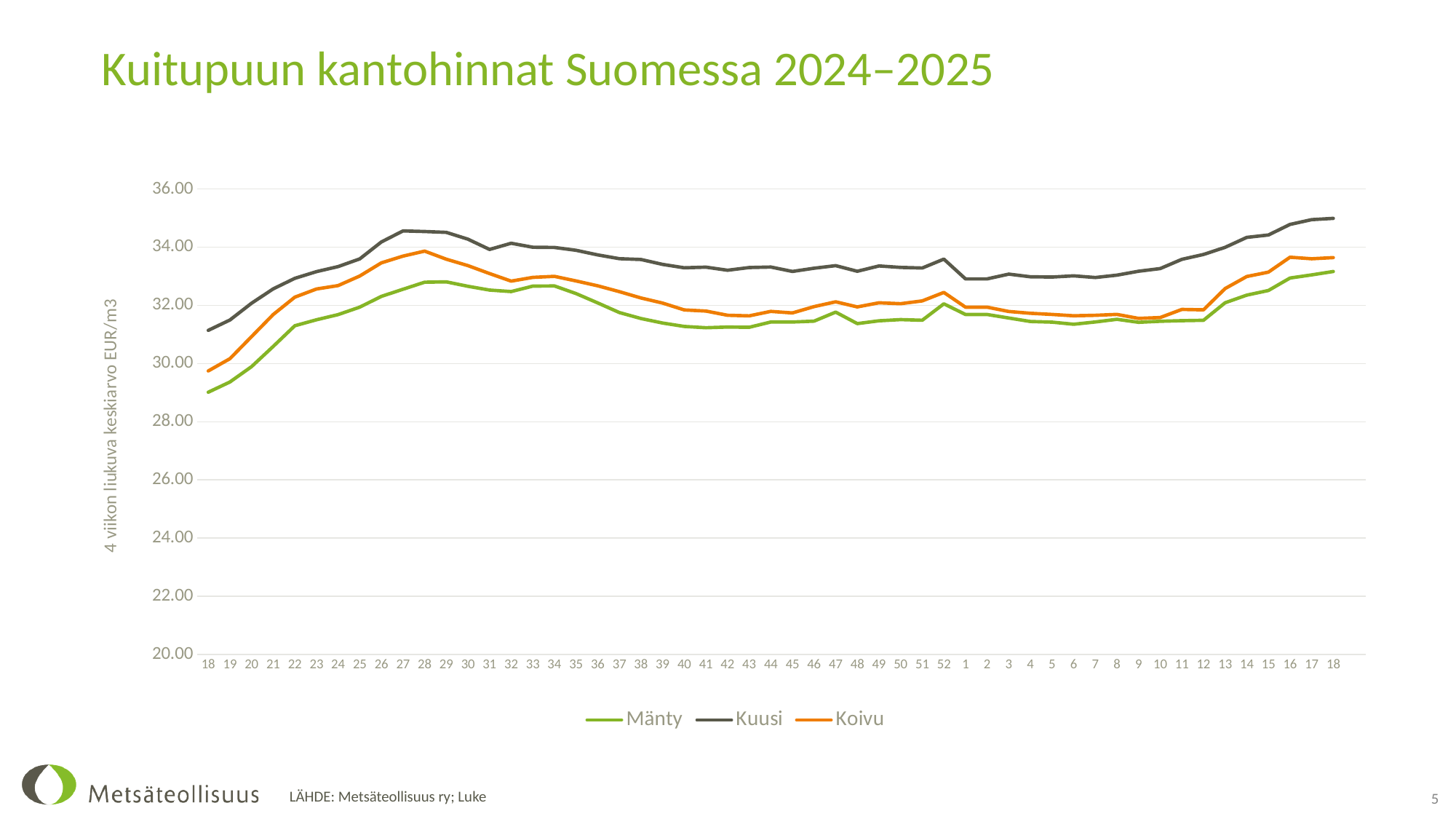
How many series does the legend list? 3 Which series is plotted with the orange line? Koivu Is the value for Koivu at week 40 greater or less than 32.00? less What kind of chart is shown on the slide? line chart Does the Mänty line rise or fall from week 18 to week 27? rise Is the value for Mänty at the first week (18) greater or less than 30.00? less Which series has the lowest values across the whole chart? Mänty Which series has the highest values across the whole chart? Kuusi What is the title of the chart? Kuitupuun kantohinnat Suomessa 2024–2025 At week 27, which is larger: Koivu or Mänty? Koivu Is the value for Kuusi at the last week (18) greater or less than 34.00? greater